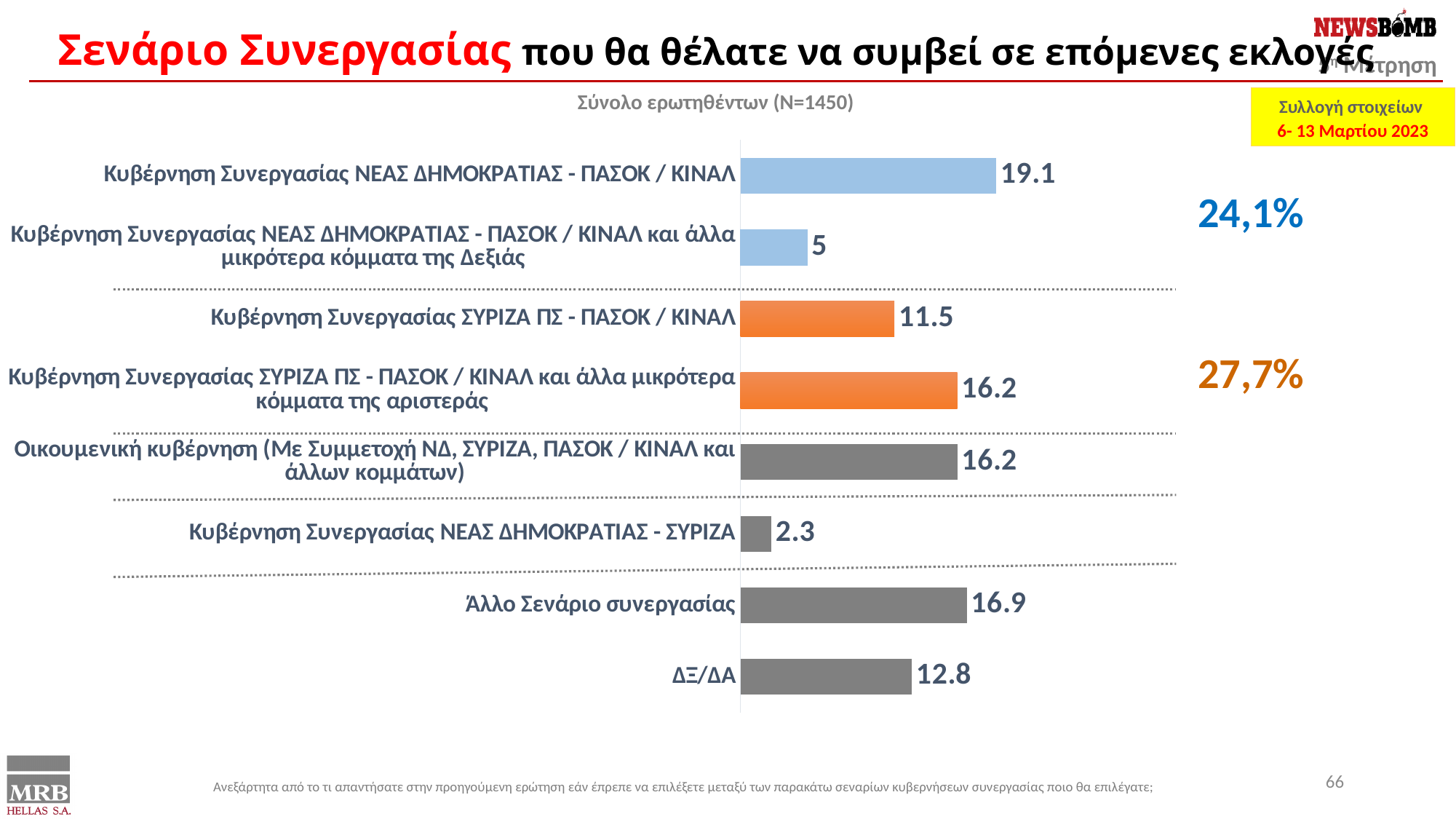
What is the value for Κυβέρνηση Συνεργασίας ΝΕΑΣ ΔΗΜΟΚΡΑΤΙΑΣ - ΠΑΣΟΚ / ΚΙΝΑΛ? 19.1 Which category has the lowest value? Κυβέρνηση Συνεργασίας ΝΕΑΣ ΔΗΜΟΚΡΑΤΙΑΣ - ΣΥΡΙΖΑ What combined percentage is shown next to the two blue bars (ΝΕΑΣ ΔΗΜΟΚΡΑΤΙΑΣ - ΠΑΣΟΚ / ΚΙΝΑΛ scenarios)? 24,1% Which category has the highest value? Κυβέρνηση Συνεργασίας ΝΕΑΣ ΔΗΜΟΚΡΑΤΙΑΣ - ΠΑΣΟΚ / ΚΙΝΑΛ What kind of chart is shown on the slide? Bar chart What combined percentage is shown next to the two orange bars (ΣΥΡΙΖΑ ΠΣ scenarios)? 27,7% What is the difference between the value for Κυβέρνηση Συνεργασίας ΝΕΑΣ ΔΗΜΟΚΡΑΤΙΑΣ - ΠΑΣΟΚ / ΚΙΝΑΛ and the value for Κυβέρνηση Συνεργασίας ΣΥΡΙΖΑ ΠΣ - ΠΑΣΟΚ / ΚΙΝΑΛ? 7.6 What is the value for Κυβέρνηση Συνεργασίας ΝΕΑΣ ΔΗΜΟΚΡΑΤΙΑΣ - ΣΥΡΙΖΑ? 2.3 Which is larger: the value for Άλλο Σενάριο συνεργασίας or the value for ΔΞ/ΔΑ? Άλλο Σενάριο συνεργασίας What is the value for ΔΞ/ΔΑ? 12.8 How many categories are shown in the bar chart? 8 What is the value for Άλλο Σενάριο συνεργασίας? 16.9